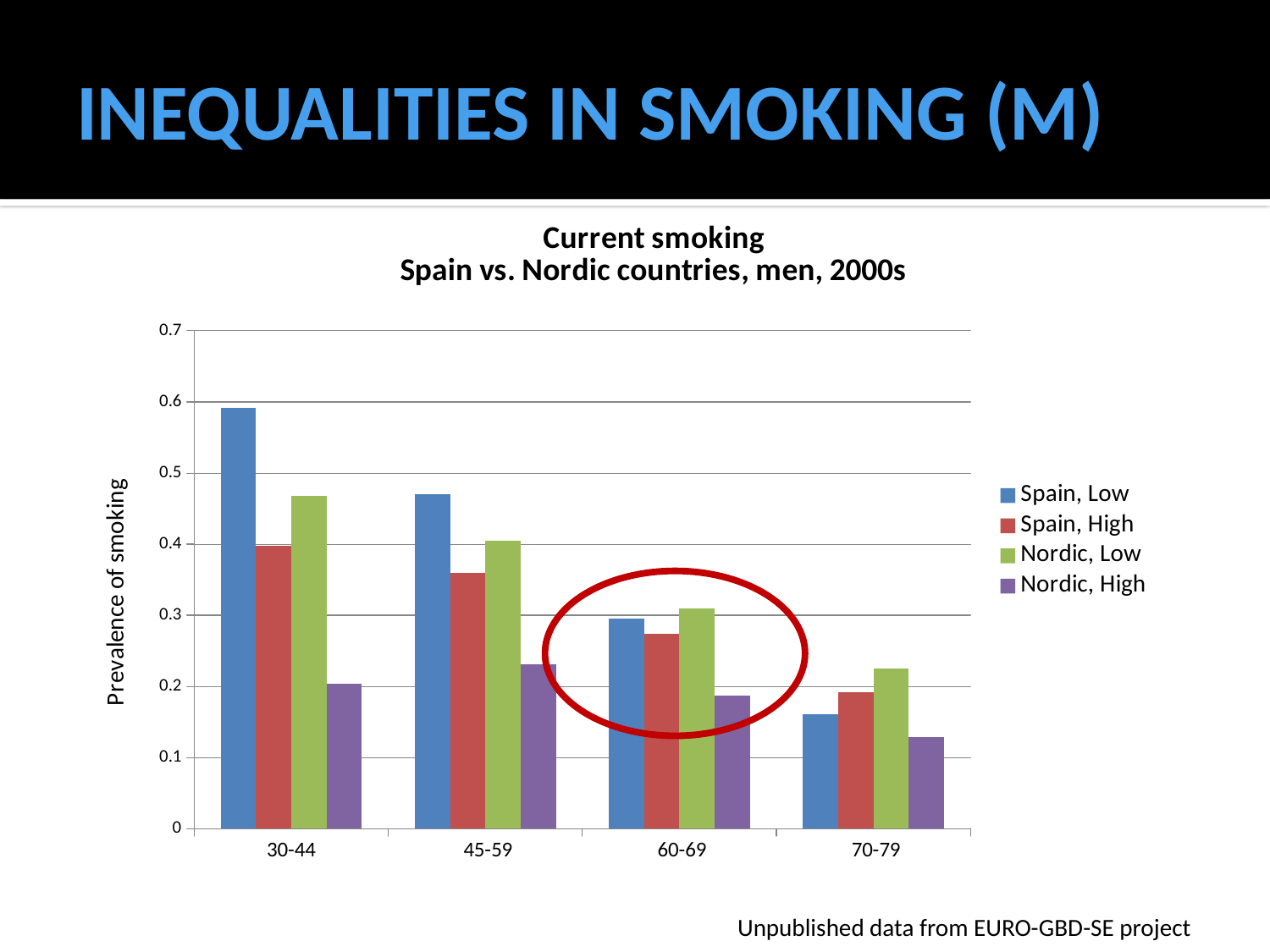
In the 30-44 age group, which is larger: Spain, Low or Nordic, Low? Spain, Low Which age group is circled in red on the chart? 60-69 Is the value for Spain, Low in the 30-44 age group greater or less than 0.5? greater How many series does the legend list? 4 Is the value for Spain, High in the 45-59 age group greater or less than 0.4? less Which series has the highest value in the 70-79 age group? Nordic, Low Which age group has the highest value for Spain, Low? 30-44 Which series has the lowest value in the 70-79 age group? Nordic, High Do the values for Spain, Low rise or fall as the age groups increase along the x axis? fall What kind of chart is shown on the slide? bar chart Is the value for Spain, Low in the 70-79 age group greater or less than 0.2? less How many age groups are shown on the x axis? 4